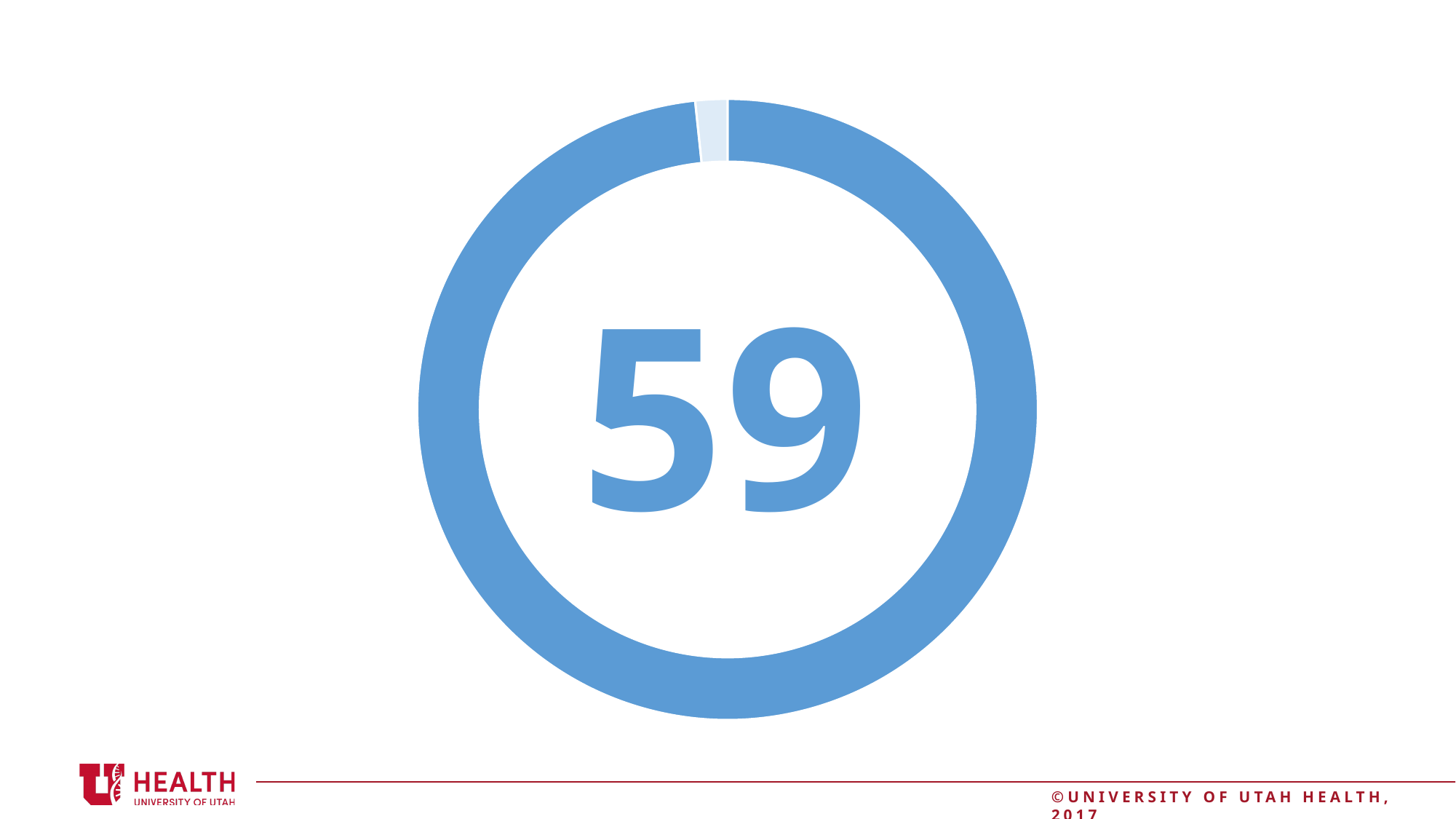
What kind of chart is shown on the slide? Doughnut chart What number is printed in the centre of the doughnut chart? 59 Does the doughnut chart have a legend? No How many segments does the doughnut chart have? 2 Which segment of the doughnut chart is larger, the dark blue one or the light blue one? The dark blue one